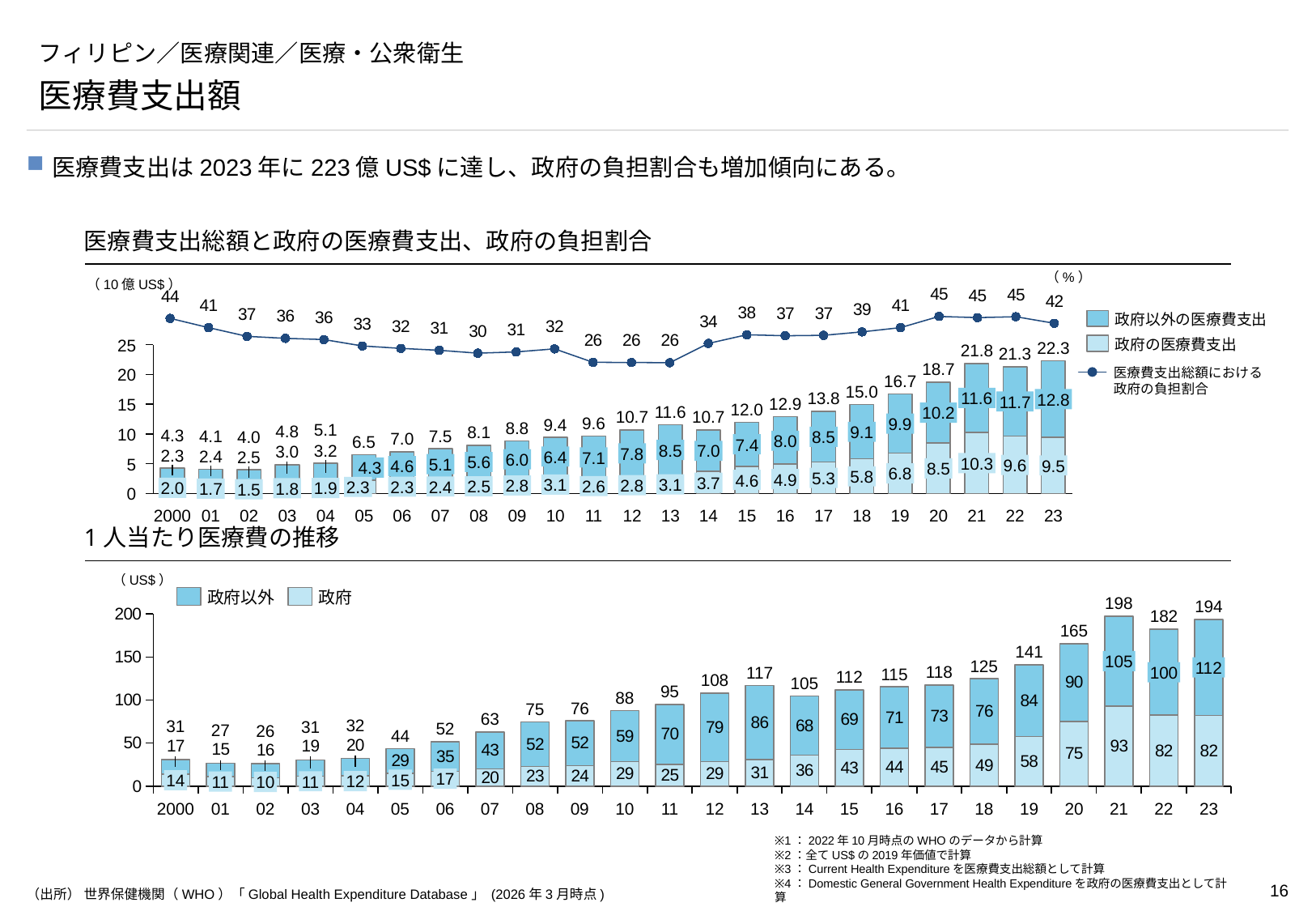
In the bottom chart, does the government (政府) per-capita value generally rise or fall from 2000 to 2023? rise In the top chart, what unit is shown for the bar values? 10億US$ In the top chart (医療費支出総額と政府の医療費支出、政府の負担割合), what is the total health expenditure labelled for 2023? 22.3 In the top chart, is government health expenditure (政府の医療費支出) larger in 2021 or 2022? 21 In the top chart, what is the difference between non-government (政府以外) and government (政府) health expenditure in 2023? 3.3 In the top chart, which year has the highest total health expenditure? 23 In the top chart, what is the government share (政府の負担割合) shown for 2011? 26 In the bottom chart, what is the total per-capita health expenditure labelled for 2021? 198 In the top chart, which year has the lowest total health expenditure? 02 In the bottom chart, what is the difference between the non-government (政府以外) and government (政府) per-capita values in 2023? 30 In the bottom chart, how many series does the legend list? 2 In the bottom chart (1人当たり医療費の推移), how many years are plotted? 24